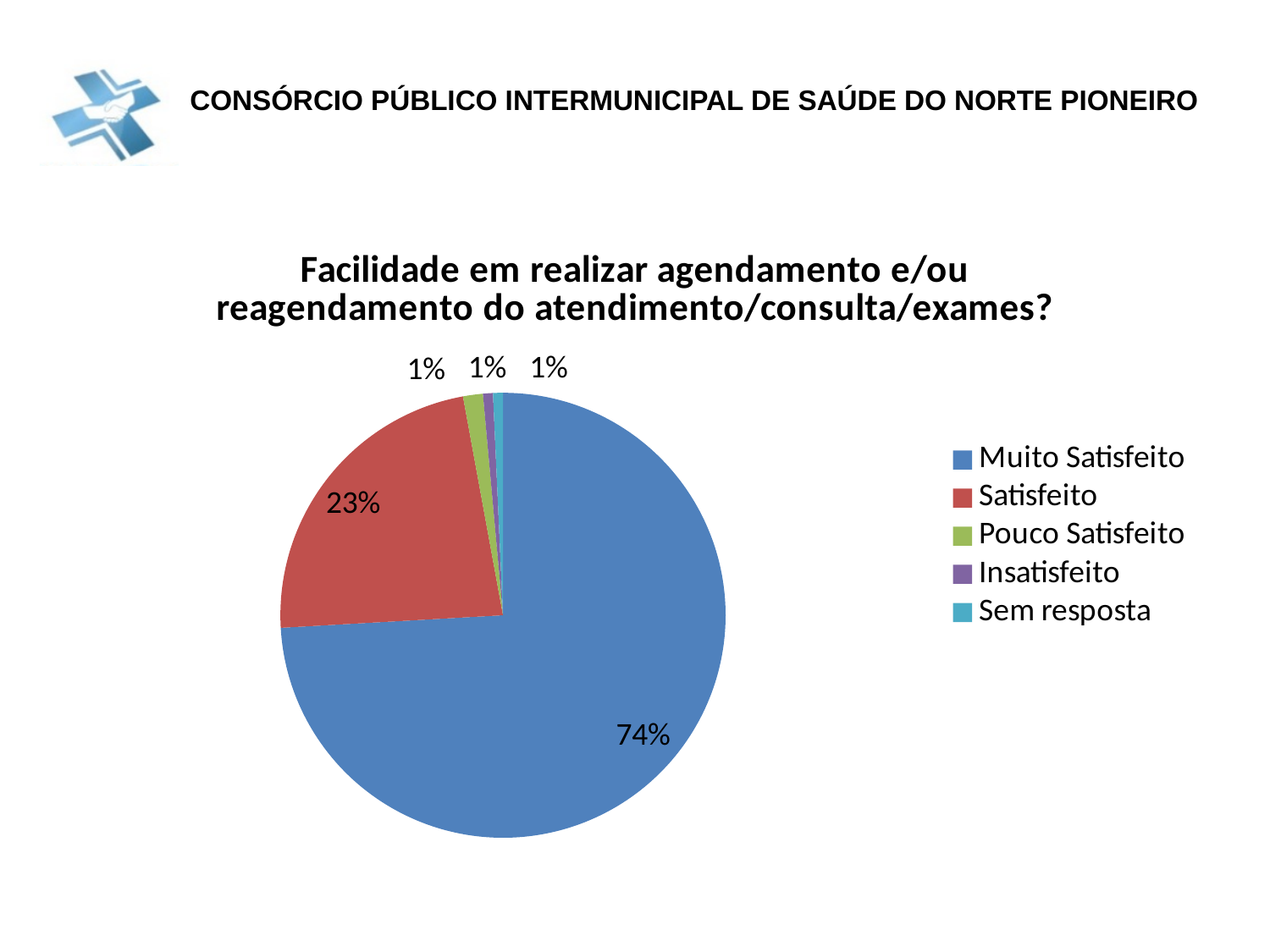
What share of the pie does "Muito Satisfeito" represent? 74% Which category has the largest slice of the pie? Muito Satisfeito What percentage of respondents answered "Pouco Satisfeito"? 1% What percentage of respondents answered "Satisfeito"? 23% What is the title of the chart? Facilidade em realizar agendamento e/ou reagendamento do atendimento/consulta/exames? What percentage of respondents answered "Muito Satisfeito"? 74% What is the difference in percentage points between "Muito Satisfeito" and "Satisfeito"? 51 percentage points What percentage of respondents answered "Sem resposta"? 1% How many categories are shown in the pie chart? 5 What type of chart is shown on the slide? Pie chart Which is larger, the share for "Satisfeito" or the share for "Insatisfeito"? Satisfeito What colour is the "Satisfeito" slice in the pie chart? Red